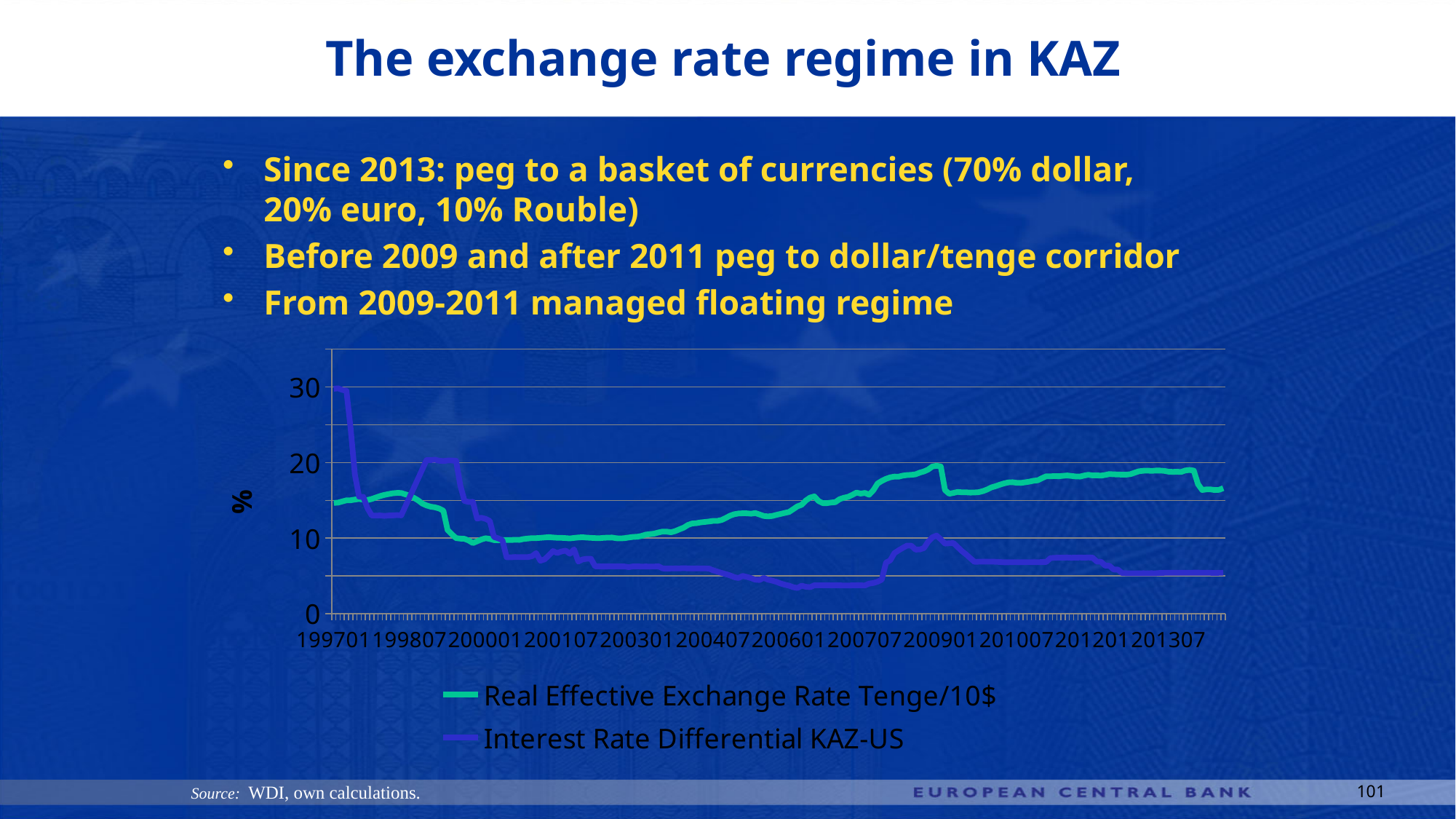
How many date labels are shown on the x axis of the chart? 12 What is the label on the vertical axis of the chart? % Is the value of the Interest Rate Differential KAZ-US at 200707 greater or less than 10? less Is the value of the Real Effective Exchange Rate Tenge/10$ at 200301 greater or less than 20? less What are the two series named in the chart legend? Real Effective Exchange Rate Tenge/10$ and Interest Rate Differential KAZ-US At 199701, which series has the higher value: Real Effective Exchange Rate Tenge/10$ or Interest Rate Differential KAZ-US? Interest Rate Differential KAZ-US What kind of chart is shown on the slide? line chart How many series does the chart legend list? 2 Is the value of the Interest Rate Differential KAZ-US at 199701 greater or less than 20? greater At 201307, which series has the higher value: Real Effective Exchange Rate Tenge/10$ or Interest Rate Differential KAZ-US? Real Effective Exchange Rate Tenge/10$ Does the Real Effective Exchange Rate Tenge/10$ rise or fall between 200301 and 200901? rise